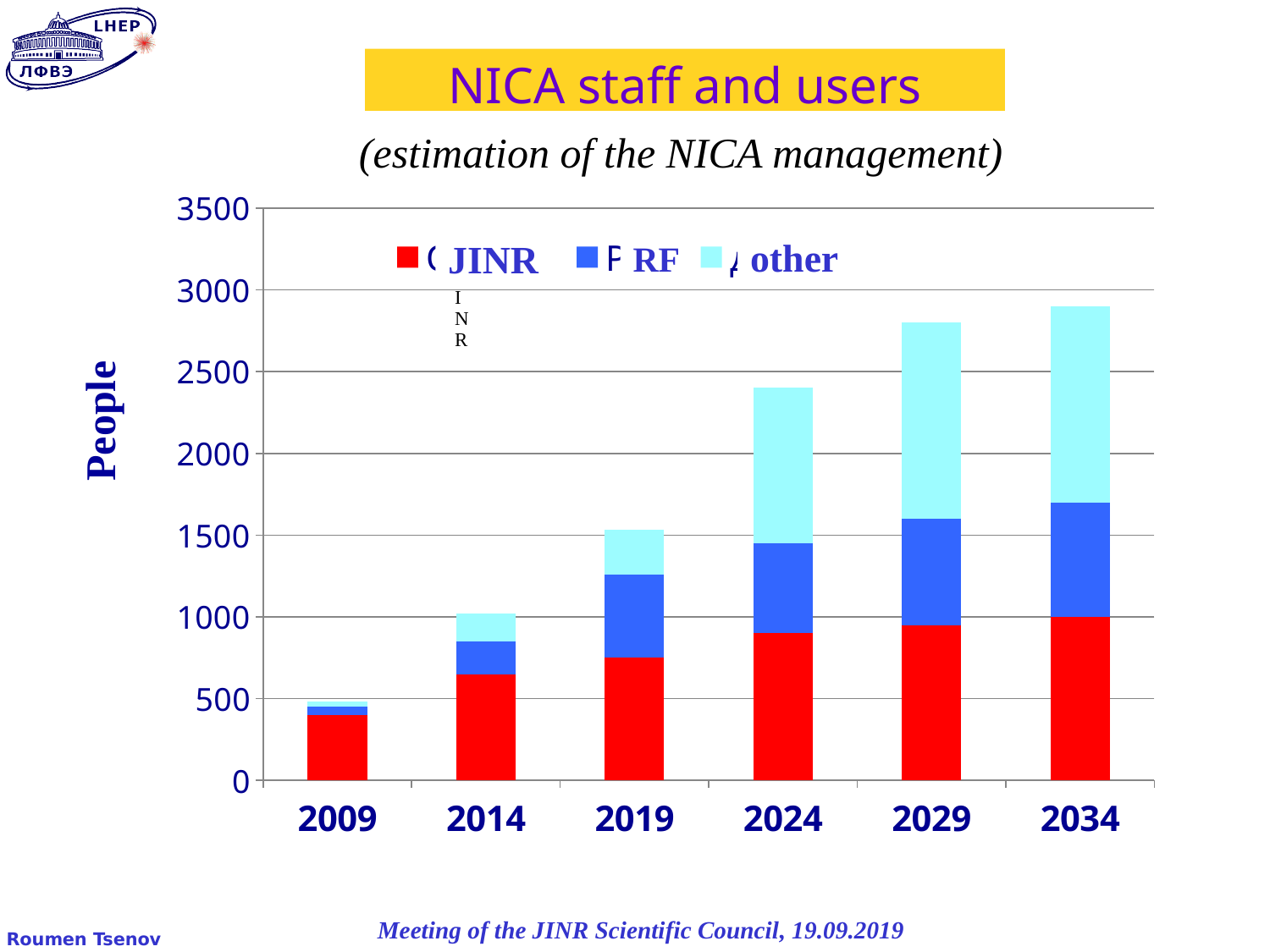
How many years are shown on the x axis of the chart? 6 What kind of chart is shown on the slide? stacked bar chart Is the total value for 2009 greater or less than 1000? less Is the total value for 2024 greater or less than 2000? greater How many series does the chart's legend list? 3 Is the JINR value for 2014 greater or less than 500? greater Which year has the lowest total number of people in the chart? 2009 Which year has the highest total number of people in the chart? 2034 Do the total bar heights rise or fall from 2009 to 2034? rise Which is larger, the JINR value for 2029 or the JINR value for 2014? 2029 What is the label on the y axis of the chart? People